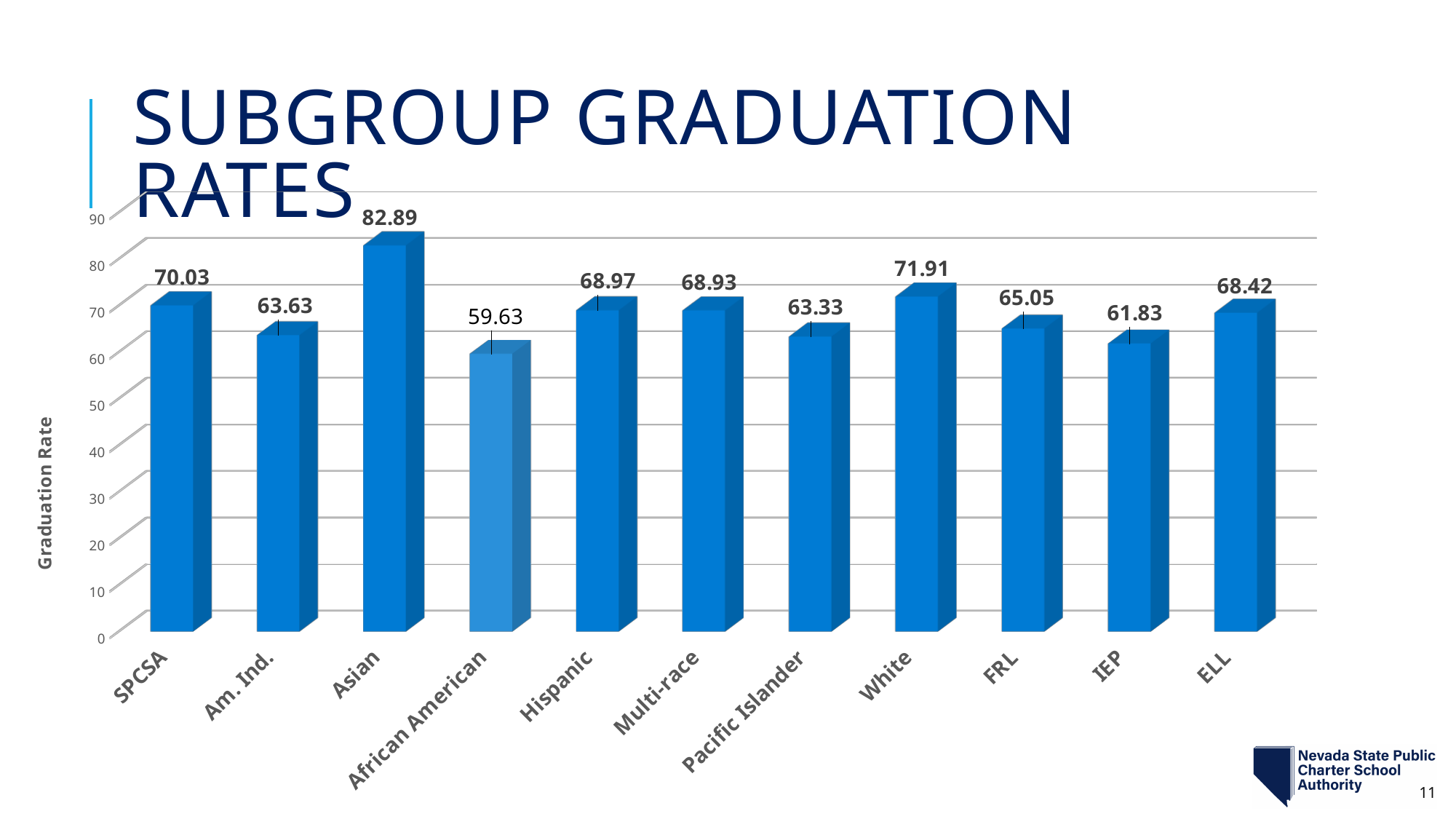
What kind of chart is shown on the slide? bar chart How many subgroup categories are shown on the x axis? 11 Which has a higher graduation rate, White or ELL? White Which subgroup has the lowest graduation rate? African American What is the graduation rate for IEP students? 61.83 What is the graduation rate for the SPCSA category? 70.03 Is the graduation rate for Pacific Islander greater or less than 70? less What is the difference between the graduation rates for Asian and African American students? 23.26 What is the graduation rate for Asian students? 82.89 Which subgroup has the highest graduation rate? Asian What is the difference between the graduation rates for White and FRL students? 6.86 What is the title of the chart on the slide? Subgroup Graduation Rates